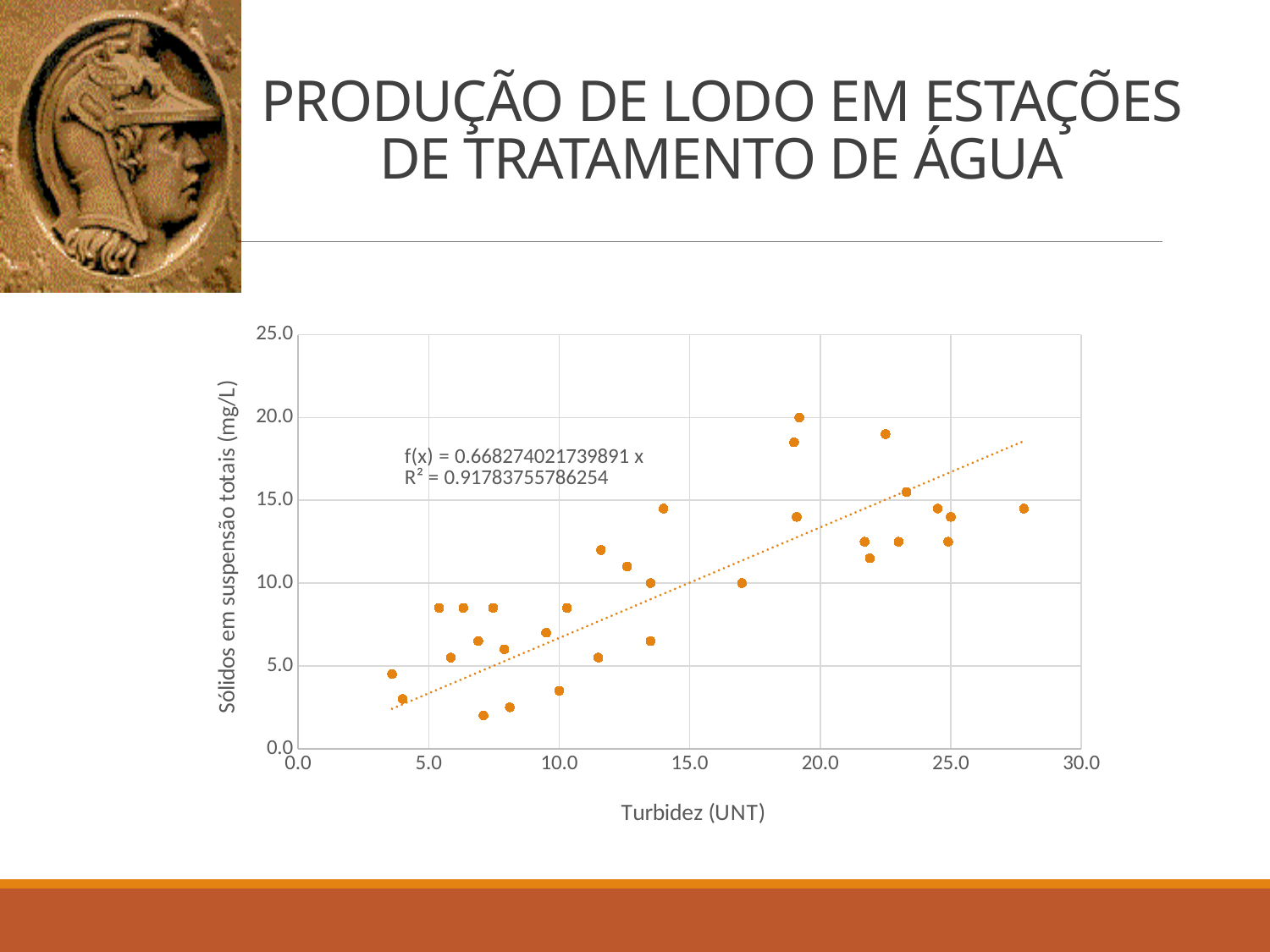
What kind of chart is shown on the slide? scatter plot Is the lowest plotted value of Sólidos em suspensão totais greater or less than 5.0 mg/L? less What is the R² value printed on the chart? 0.91783755786254 Is the highest plotted value of Sólidos em suspensão totais greater or less than 15.0 mg/L? greater Do the plotted values generally rise or fall as turbidity increases along the x axis? rise What is the maximum value shown on the y axis of the chart? 25.0 Is the trendline value at Turbidez 25.0 UNT greater or less than 15.0 mg/L? greater What is the trendline equation printed on the chart? f(x) = 0.668274021739891 x What is the title of the x axis of the chart? Turbidez (UNT) What is the title of the y axis of the chart? Sólidos em suspensão totais (mg/L) What is the maximum value shown on the x axis of the chart? 30.0